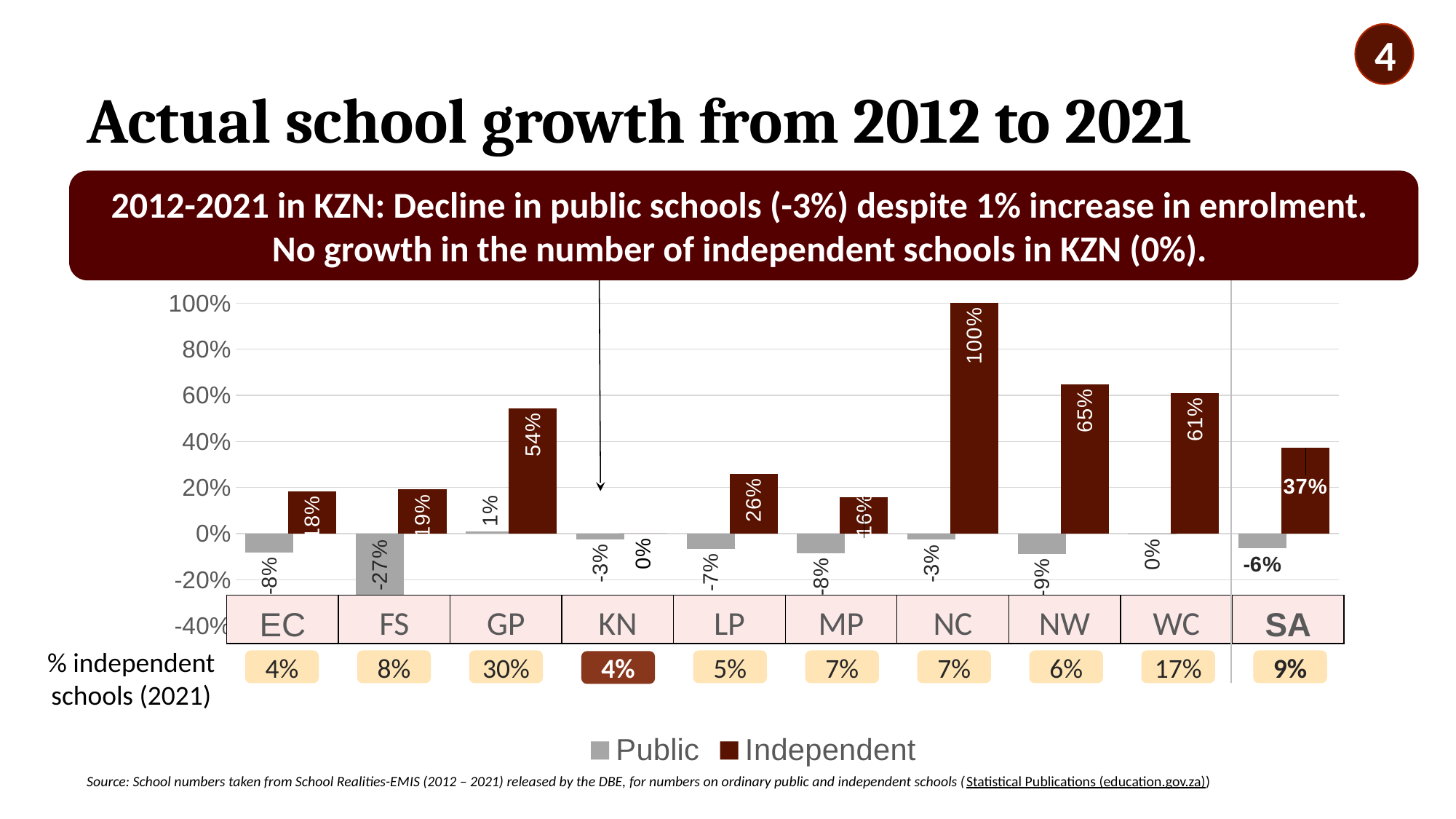
What is the Independent school growth value for NC? 100% Which province has the highest Independent school growth? NC What kind of chart is shown on the slide? Bar chart What is the Public school growth value for FS? -27% How many categories are shown on the x axis of the chart? 10 What is the difference between the Independent growth values for NW and WC? 4 percentage points What is the Public school growth value for KN? -3% Which category has the lowest Public school growth? FS What is the Independent school growth value for SA? 37% What are the two series named in the legend? Public and Independent Which has the larger Independent growth value, GP or LP? GP How many series does the legend list? 2